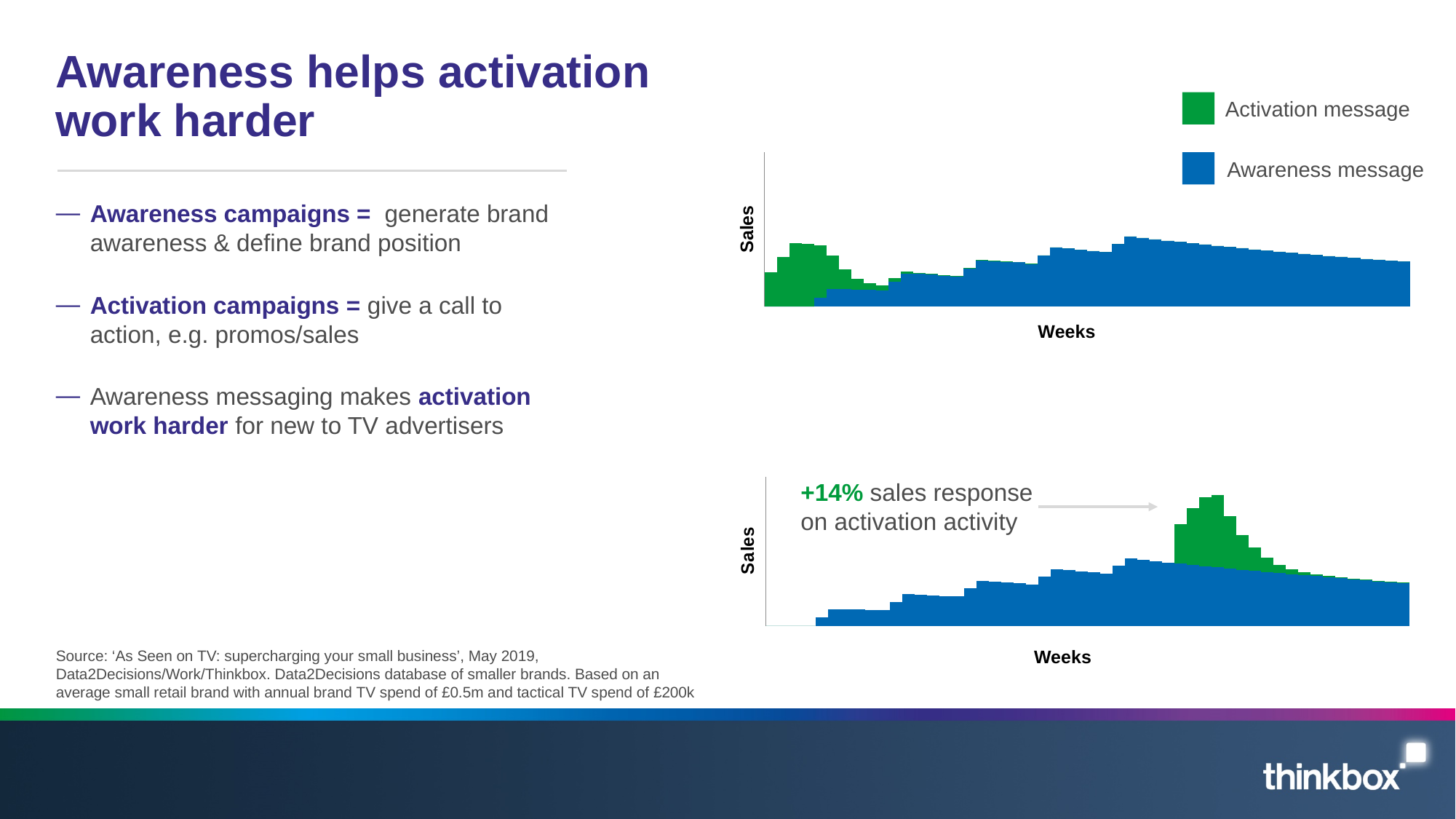
In the top chart, does the Activation message series appear at the start or the end of the weeks shown? At the start In the bottom chart, is the peak of the Activation message series higher or lower than the peak of the Awareness message series? Higher In the top chart, does the Awareness message series rise or fall over the final weeks shown? Fall What is the label on the horizontal axis of the top chart? Weeks How many series does the legend list for the charts on the slide? 2 Which colour represents the Awareness message series in the charts? Blue In the bottom chart, what percentage sales response on activation activity is annotated? +14% What kind of chart is the top chart on the slide? Bar chart What are the two series named in the legend? Activation message and Awareness message In the bottom chart, does the Awareness message series rise or fall over the first half of the weeks shown? Rise What is the label on the vertical axis of the bottom chart? Sales